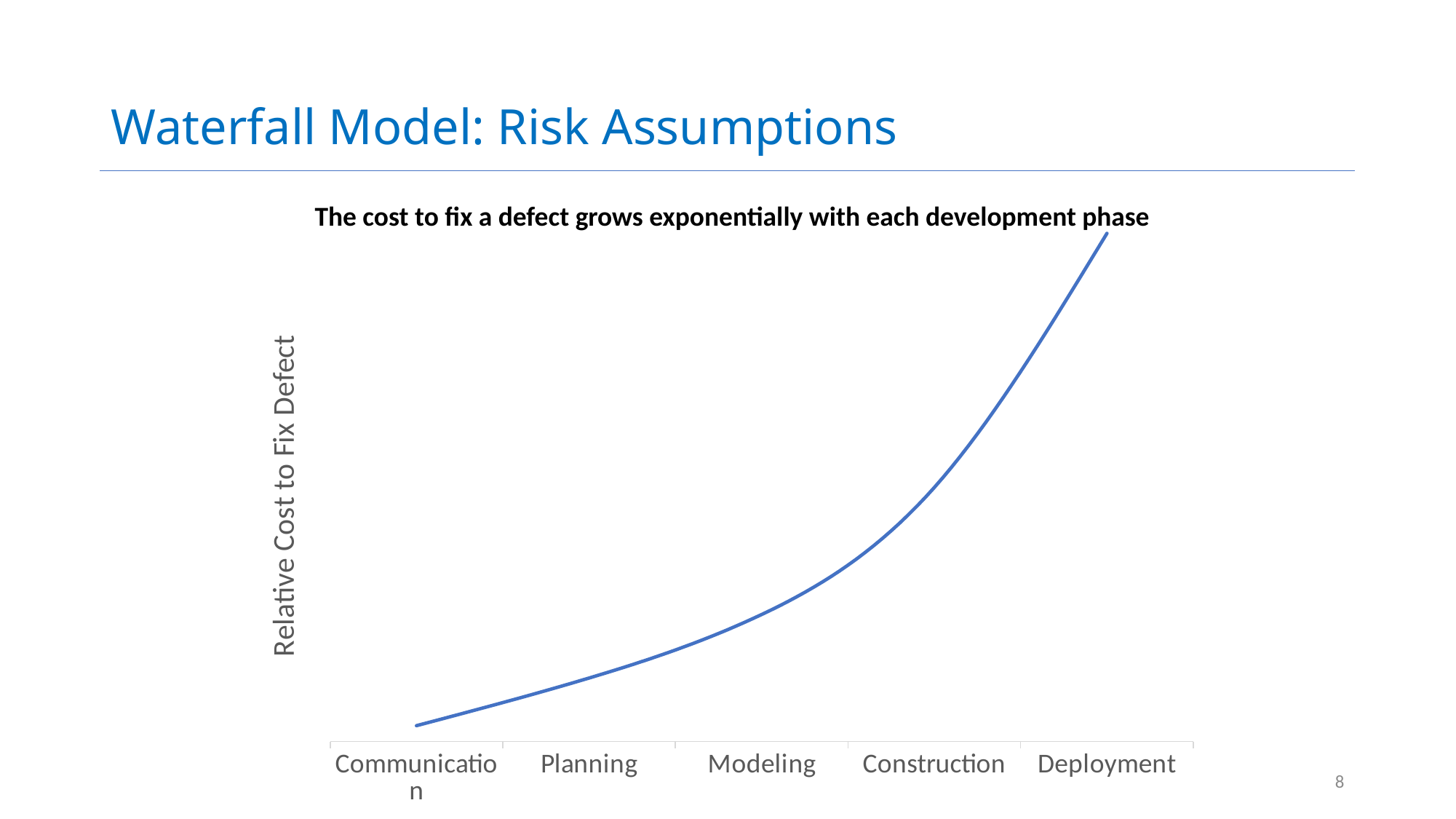
What kind of chart is shown on the slide? line chart Does the relative cost to fix a defect rise or fall from Communication to Deployment? rise How many development phases are shown along the x axis of the chart? 5 Which phase has a lower relative cost to fix a defect, Planning or Deployment? Planning Which phase comes immediately after Modeling on the x axis? Construction Which phase has a higher relative cost to fix a defect, Modeling or Construction? Construction Which development phase has the lowest relative cost to fix a defect? Communication What is the title of the chart? The cost to fix a defect grows exponentially with each development phase What is the label on the vertical axis of the chart? Relative Cost to Fix Defect Which development phase has the highest relative cost to fix a defect? Deployment